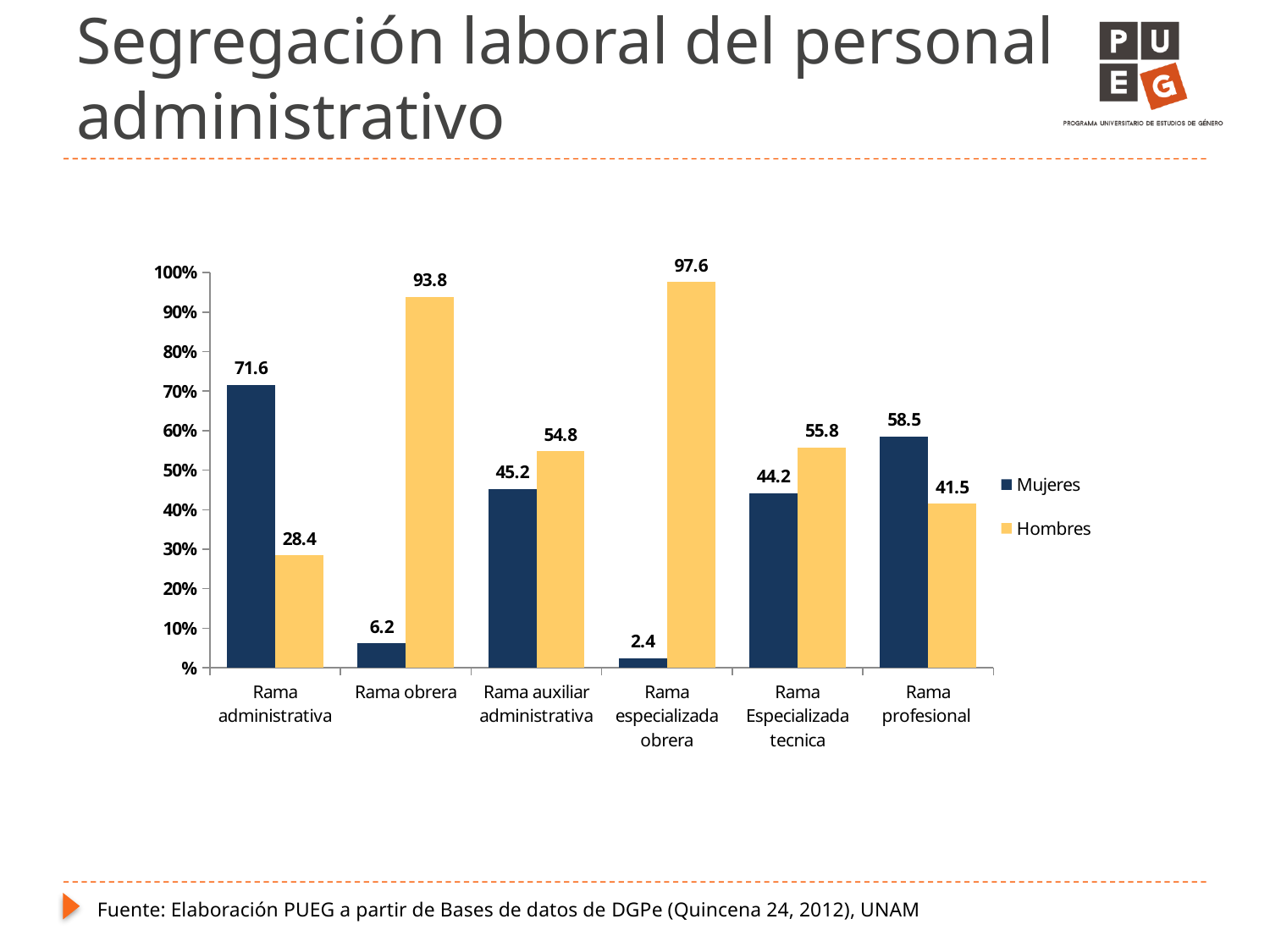
Is the value for Mujeres in Rama profesional greater or less than 50%? greater Which is larger in Rama Especializada tecnica, Mujeres or Hombres? Hombres What kind of chart is shown on the slide? Bar chart What is the value for Hombres in Rama obrera? 93.8 What is the value for Mujeres in Rama administrativa? 71.6 Which category has the lowest value for Mujeres? Rama especializada obrera What is the value for Hombres in Rama profesional? 41.5 How many series does the legend list? 2 What is the value for Mujeres in Rama especializada obrera? 2.4 What is the difference between Hombres and Mujeres in Rama auxiliar administrativa? 9.6 How many categories are shown on the x axis? 6 Which category has the highest value for Hombres? Rama especializada obrera